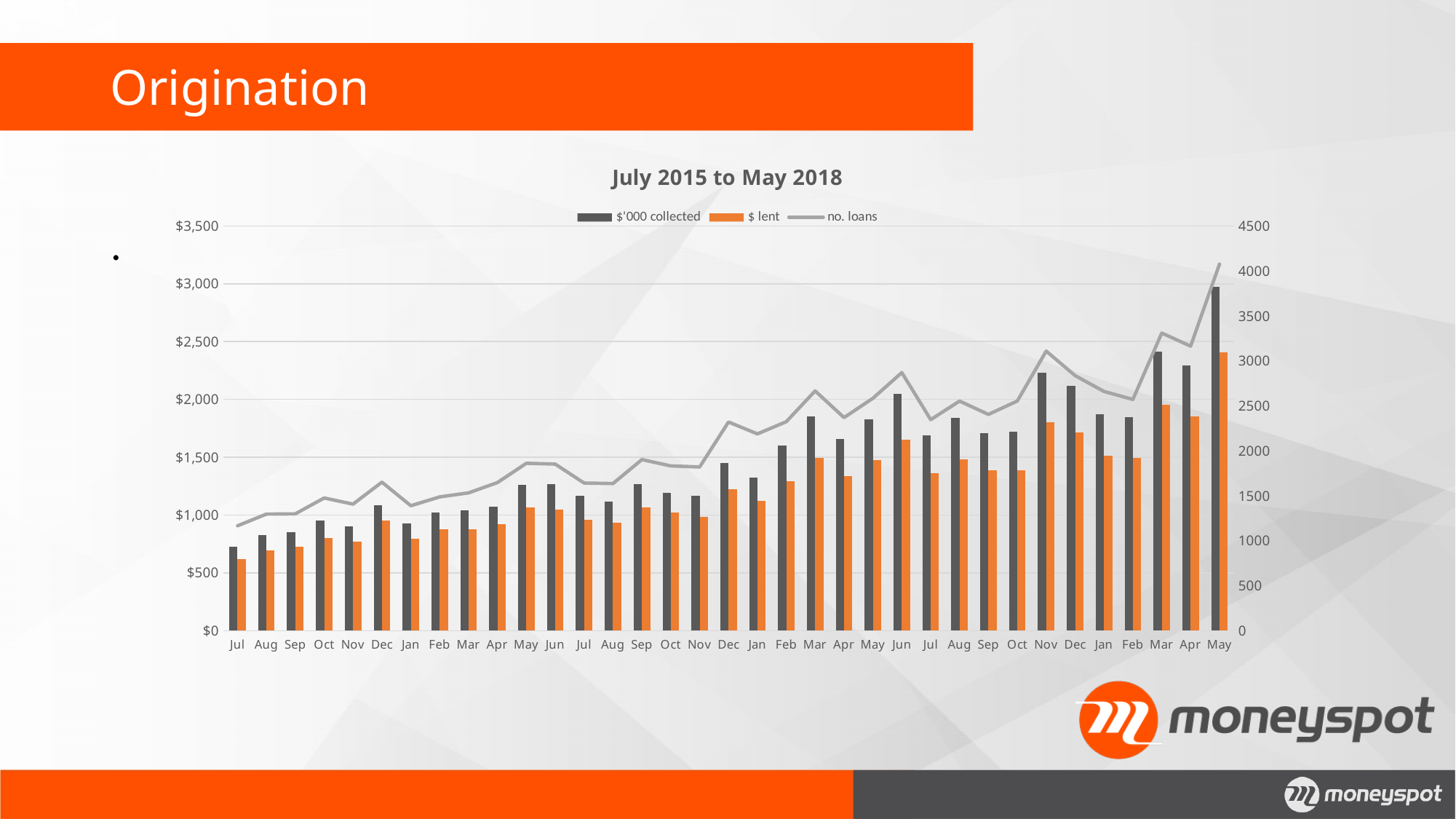
Overall, do the no. loans values rise or fall from July 2015 to May 2018? rise Is the no. loans value for the final May (May 2018) greater or less than 3500? greater Which series is drawn as a line rather than bars? no. loans Is the $'000 collected value for the final May (May 2018) greater or less than $2,500? greater What is the title of the chart? July 2015 to May 2018 In which month is the $'000 collected bar highest? May (2018, the last month) How many months are plotted along the x axis? 35 What kind of chart is this? Combined bar and line chart Is the $ lent value for the first Jul (July 2015) greater or less than $1,000? less In the final May (May 2018), which is larger: $'000 collected or $ lent? $'000 collected In which month is the $ lent bar lowest? Jul (2015, the first month) How many series does the chart legend list? 3